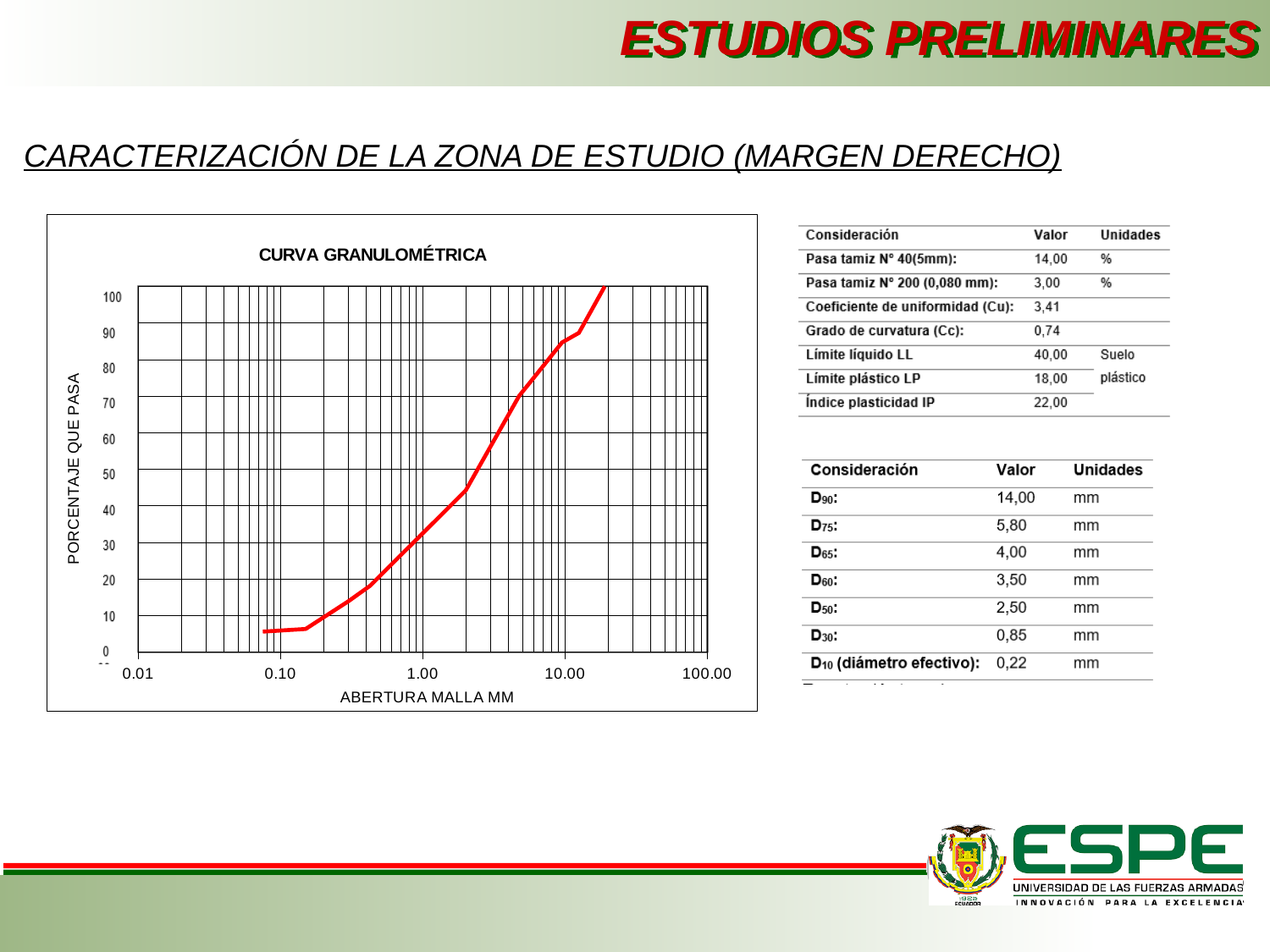
How many labelled tick values are shown on the x axis of the chart? 5 What is the highest tick value shown on the y axis of the chart? 100 What is the label of the x axis of the chart? ABERTURA MALLA MM Is the value of the curve at an opening of 1.00 mm greater or less than 20? greater Is the value of the curve at an opening of 1.00 mm greater or less than 40? less Is the percentage passing at 10.00 mm larger or smaller than at 1.00 mm? larger What kind of chart is shown on the slide? line chart Is the value of the curve at an opening of 0.10 mm greater or less than 10? less How many lines are plotted in the chart? 1 Does the curve in the chart rise or fall as the x axis values increase? rise What is the title of the chart on the slide? CURVA GRANULOMÉTRICA